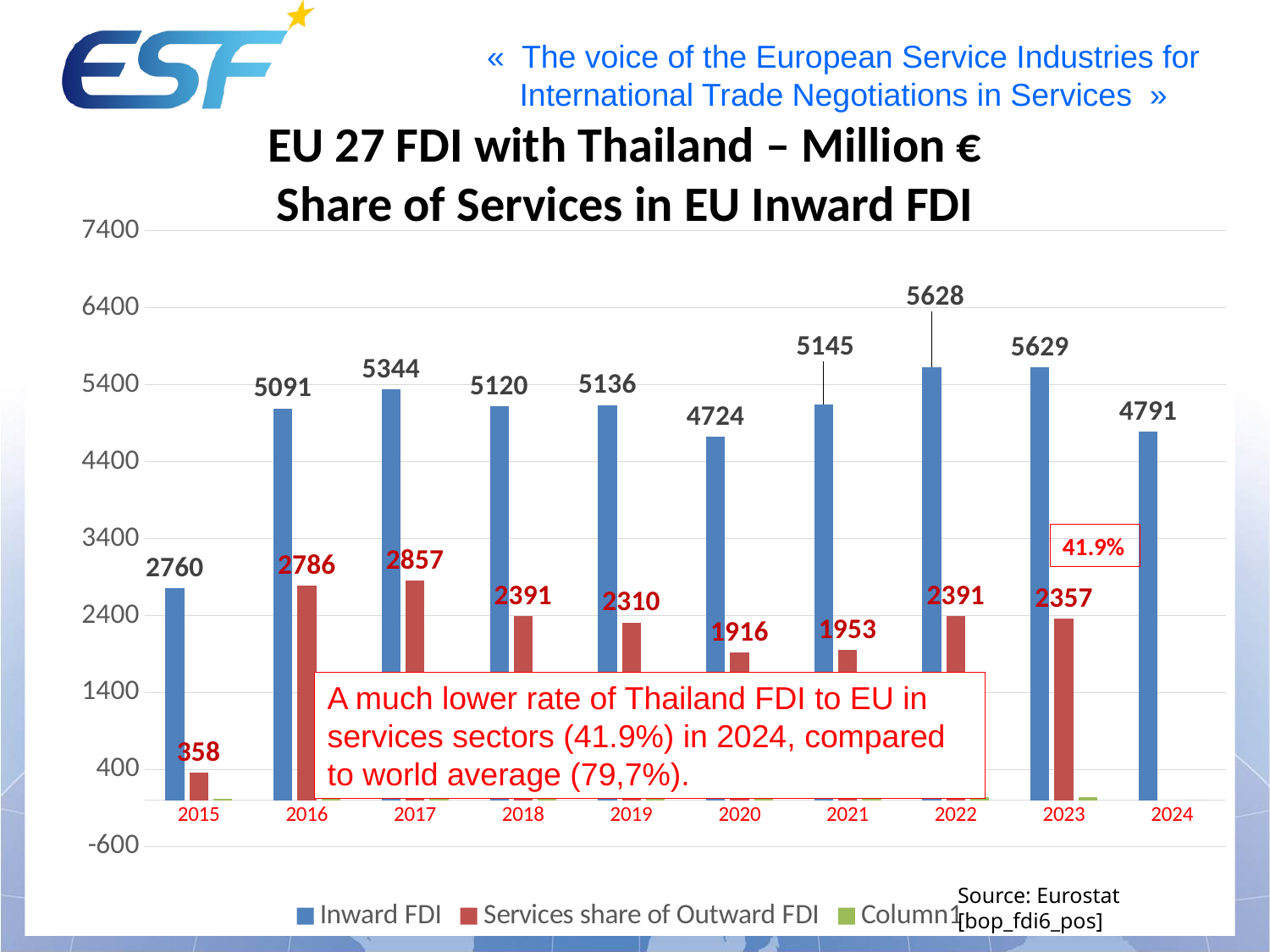
Which year has the lowest Inward FDI value? 2015 What is the Services share of Outward FDI value for 2019? 2310 Which is larger, the Inward FDI value for 2017 or for 2018? 2017 What is the difference between the Inward FDI values for 2023 and 2024? 838 Which year has the highest Services share of Outward FDI value? 2017 How many series does the legend list? 3 Is the Inward FDI value for 2020 greater or less than 4400? greater What is the difference between the Services share of Outward FDI values for 2017 and 2016? 71 Do the Services share of Outward FDI values rise or fall from 2017 to 2020? fall How many years are shown on the x axis? 10 What is the Inward FDI value for 2024? 4791 What is the Inward FDI value for 2022? 5628